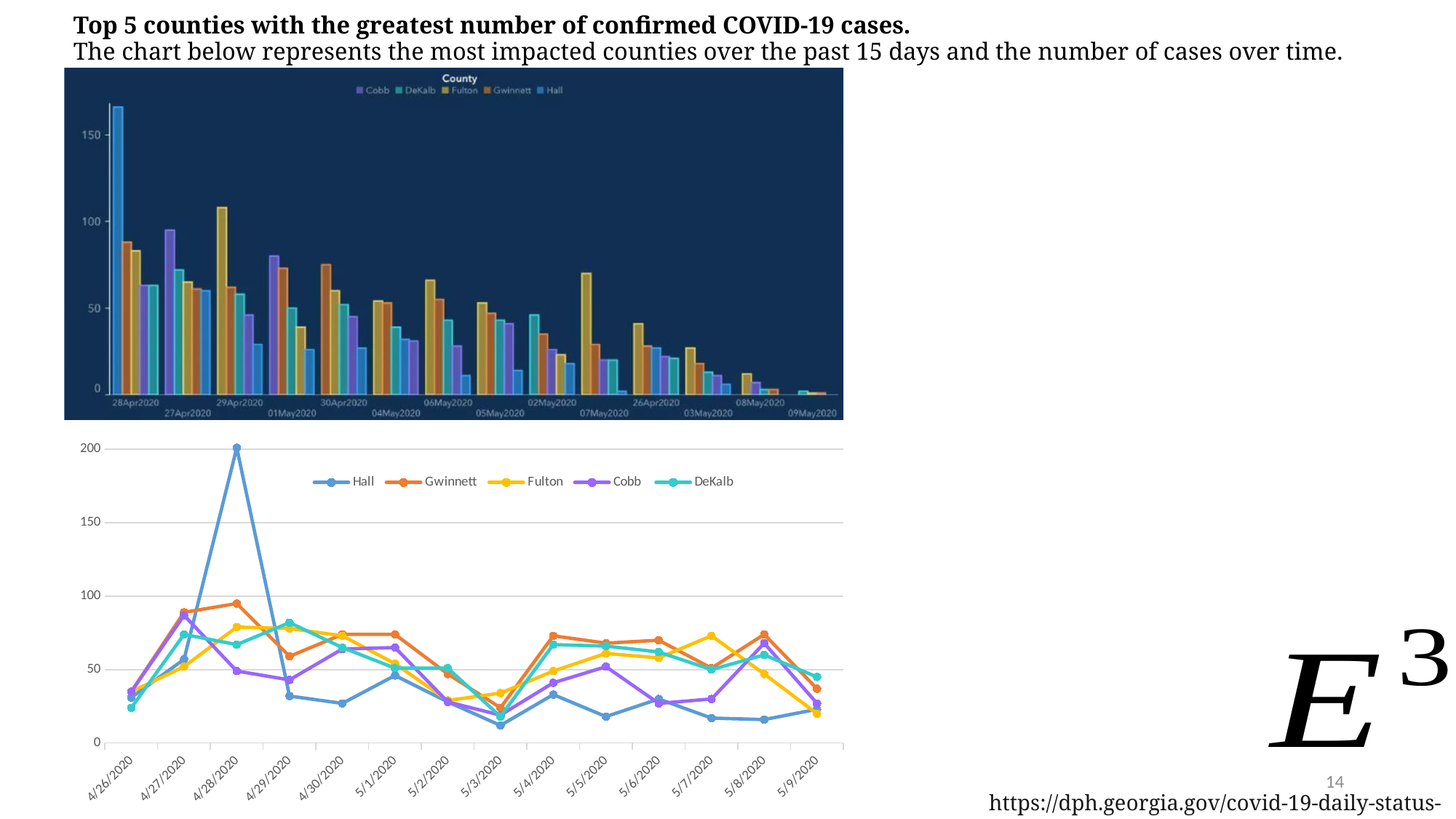
In the bottom chart, how many series does the legend list? 5 In the top chart, what is the title shown above the legend? County In the top chart, is the value for Fulton on 29Apr2020 greater or less than 100? greater In the top chart, how many counties does the legend list? 5 What kind of chart is the top chart on the slide? bar chart In the bottom chart, which county reaches the highest single value on the chart? Hall In the bottom chart, is the value for Hall on 4/28/2020 greater or less than 150? greater In the top chart, on 28Apr2020, which is larger: the Hall bar or the Gwinnett bar? Hall What kind of chart is the bottom chart on the slide? line chart In the bottom chart, how many dates are shown on the x axis? 14 In the bottom chart, on which date does the Hall line reach its highest value? 4/28/2020 In the bottom chart, is the value for Hall on 5/3/2020 greater or less than 50? less